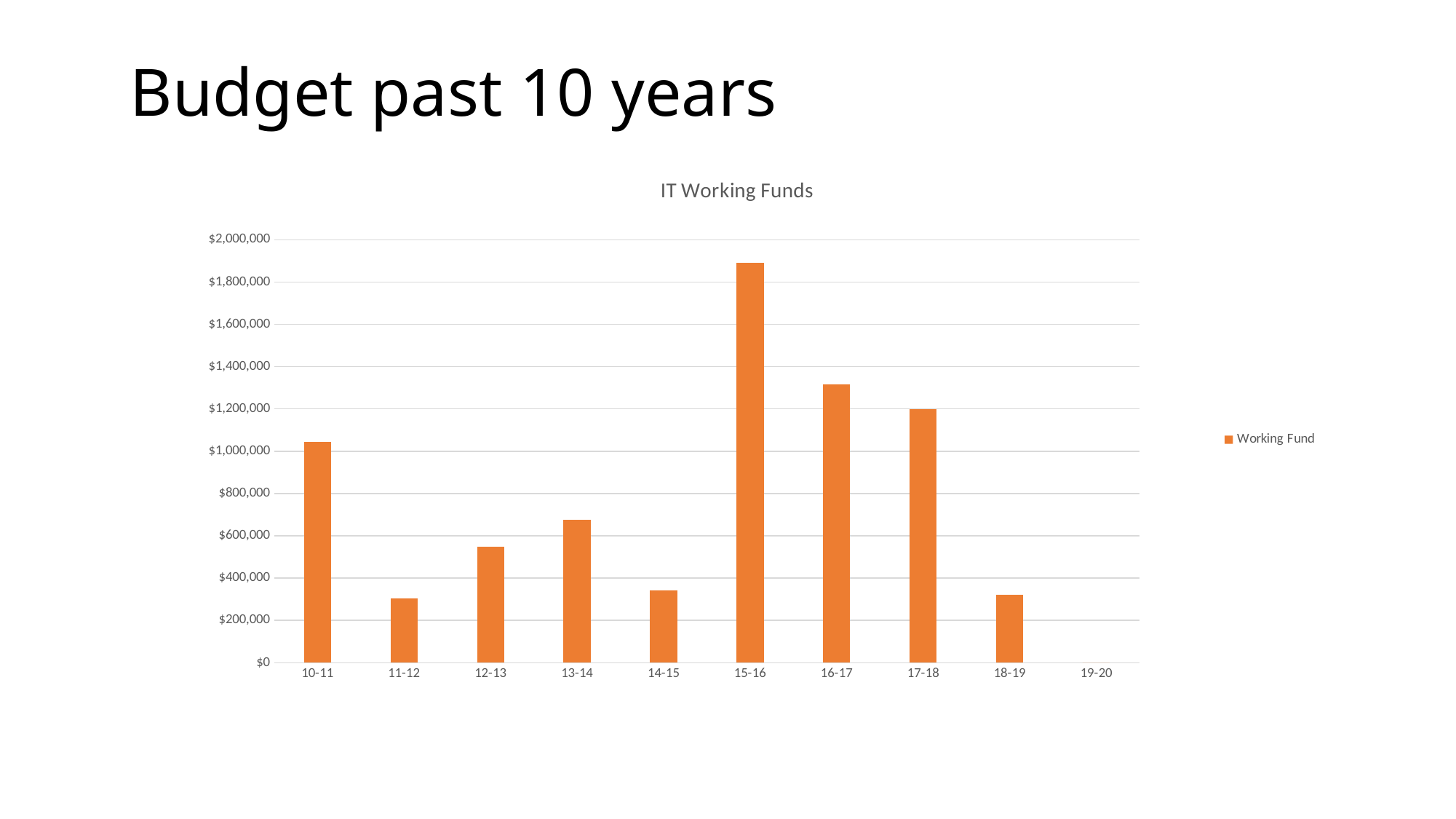
Which year has the highest Working Fund value? 15-16 Which year has the larger Working Fund value, 12-13 or 13-14? 13-14 Is the Working Fund value for 16-17 greater or less than $1,200,000? greater Is the Working Fund value for 14-15 greater or less than $400,000? less What is the title of the chart? IT Working Funds What type of chart is shown on the slide? Bar chart Which year has the larger Working Fund value, 16-17 or 17-18? 16-17 Do the Working Fund values rise or fall from 15-16 to 18-19? fall Is the Working Fund value for 15-16 greater or less than $1,800,000? greater How many series does the legend list? 1 How many year categories are shown on the x axis? 10